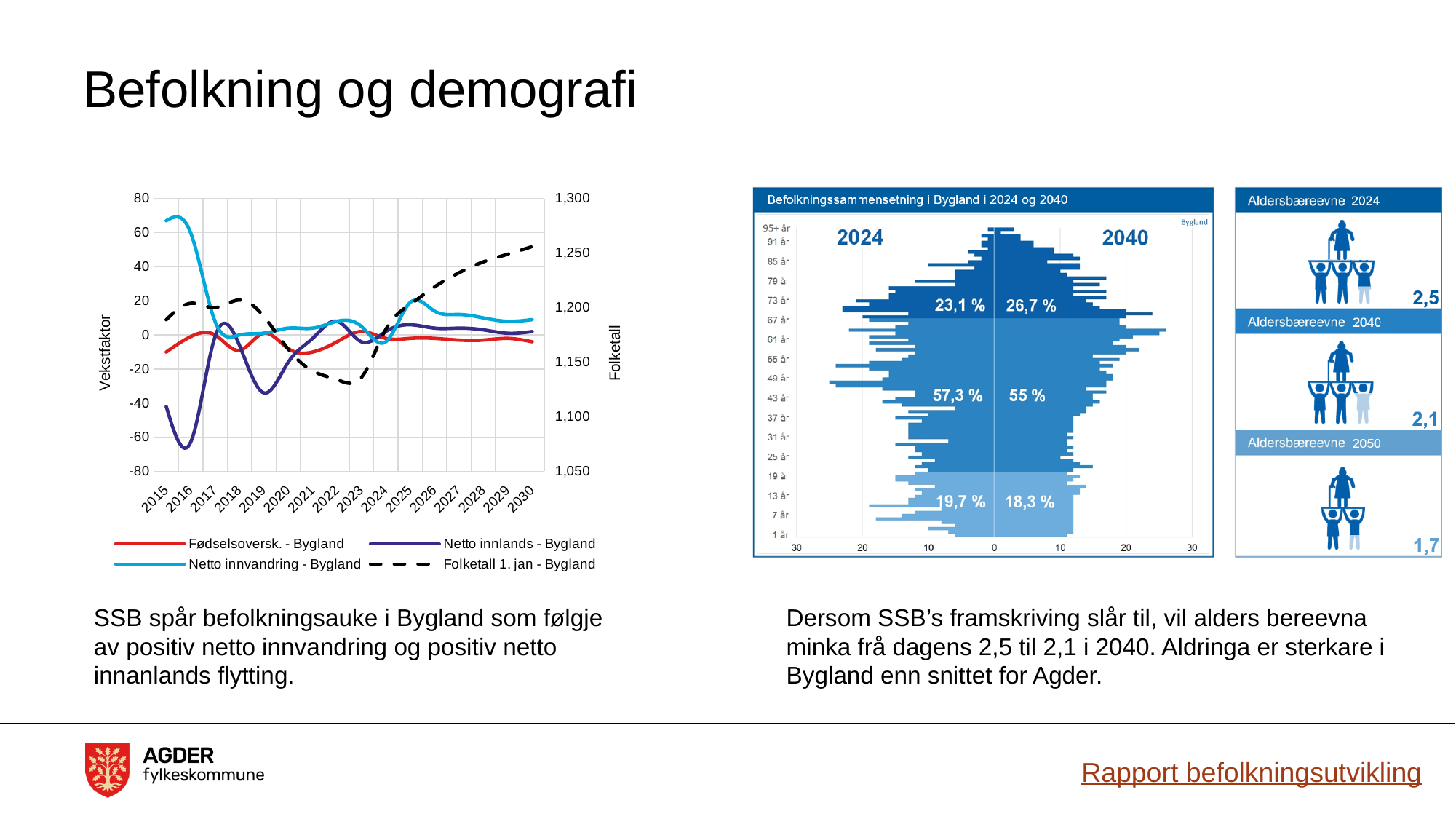
In the Befolkningssammensetning i Bygland chart, what share of the population is in the youngest age group in 2040? 18,3 % In the left-hand line chart, is the value for Netto innvandring - Bygland in 2015 greater or less than 60? greater In the Befolkningssammensetning i Bygland chart, by how many percentage points does the oldest age group's share grow from 2024 to 2040? 3,6 In the Befolkningssammensetning i Bygland chart, is the middle age group's share larger in 2024 or in 2040? 2024 How many years are shown on the x axis of the left-hand line chart? 16 How many series does the legend of the left-hand line chart list? 4 In the left-hand line chart, is the value for Netto innlands - Bygland in 2016 greater or less than -60? less What is the Aldersbæreevne value shown for 2050? 1,7 In the left-hand line chart, does the Folketall 1. jan - Bygland line rise or fall between 2023 and 2030? rise In the Befolkningssammensetning i Bygland chart, what share of the population is in the oldest age group (67 år and above) in 2024? 23,1 % What kind of chart is the left-hand chart with the Vekstfaktor and Folketall axes? line chart In the left-hand line chart, is the Folketall 1. jan - Bygland value in 2030 greater or less than 1,200? greater